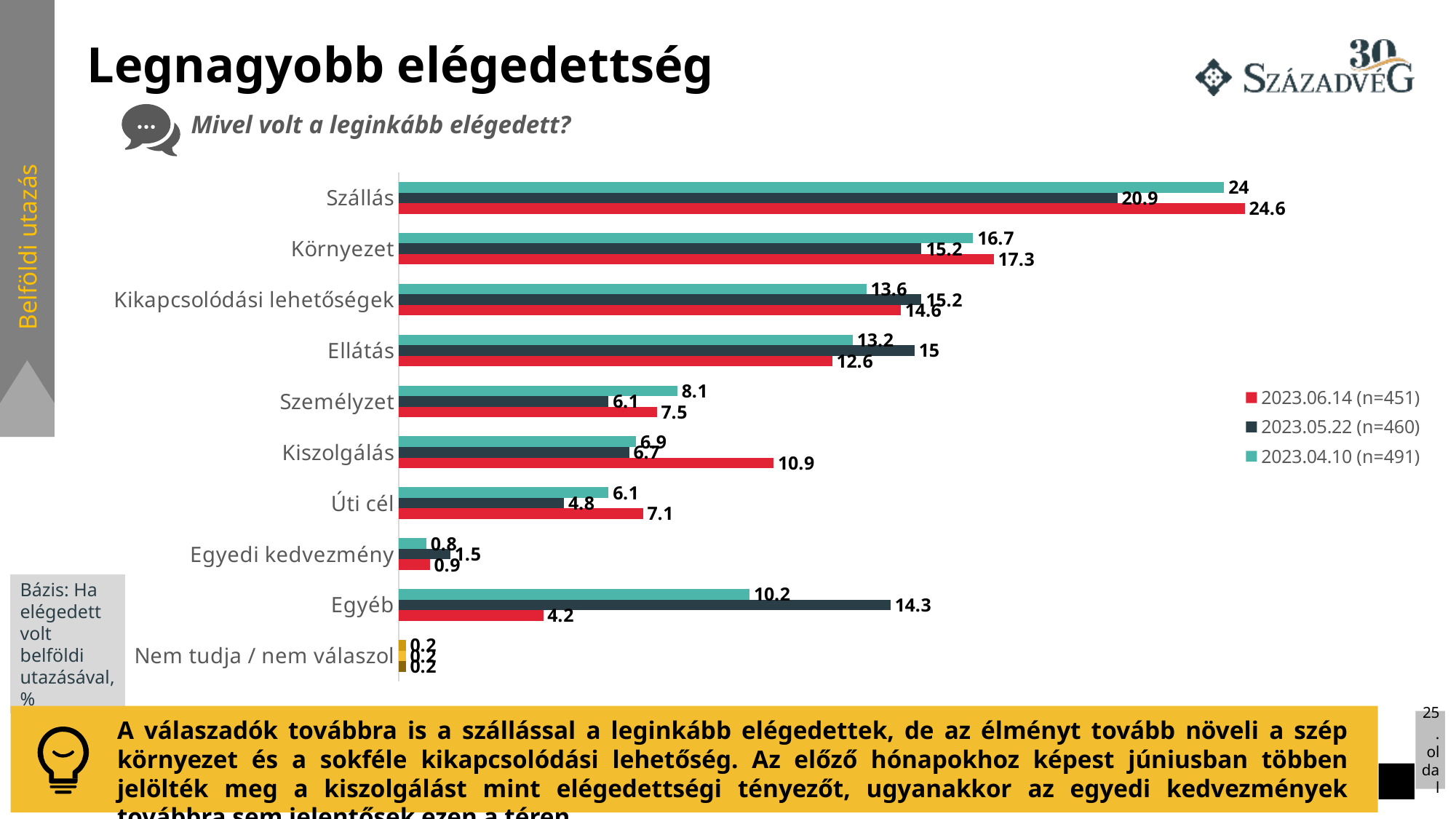
What is the value for Egyéb in the 2023.05.22 (n=460) series? 14.3 Which category has the lowest value in the 2023.05.22 (n=460) series? Nem tudja / nem válaszol What is the value for Szállás in the 2023.06.14 (n=451) series? 24.6 How many categories are shown on the chart? 10 Which category has the highest value in the 2023.06.14 (n=451) series? Szállás What is the difference between the 2023.06.14 (n=451) and 2023.05.22 (n=460) values for Kiszolgálás? 4.2 Which is larger for Ellátás: the 2023.05.22 (n=460) value or the 2023.06.14 (n=451) value? 2023.05.22 (n=460) What is the difference between the 2023.06.14 (n=451) and 2023.04.10 (n=491) values for Egyéb? 6 What is the value for Kiszolgálás in the 2023.04.10 (n=491) series? 6.9 Which series is shown in red in the legend? 2023.06.14 (n=451) How many series does the legend list? 3 What kind of chart is shown on the slide? bar chart